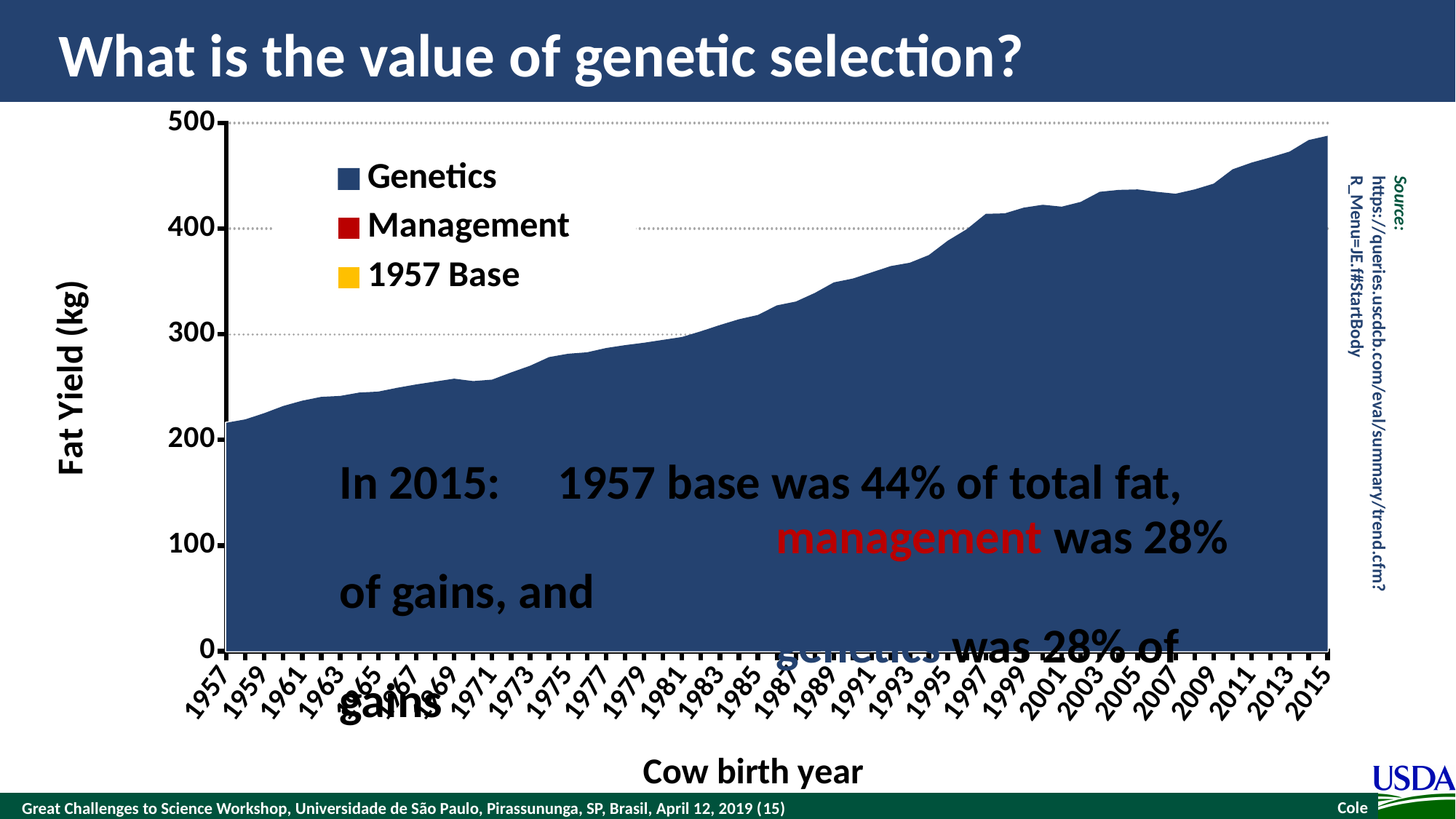
Is the fat yield for 1997 greater or less than 400? greater What is the label of the y axis? Fat Yield (kg) How many series does the legend list? 3 Is the fat yield for 1975 greater or less than 300? less Is the fat yield for 2015 greater or less than 500? less What kind of chart is shown on the slide? Area chart What is the label of the x axis? Cow birth year Which year has the highest fat yield? 2015 Does fat yield rise or fall from 1957 to 2015? Rise